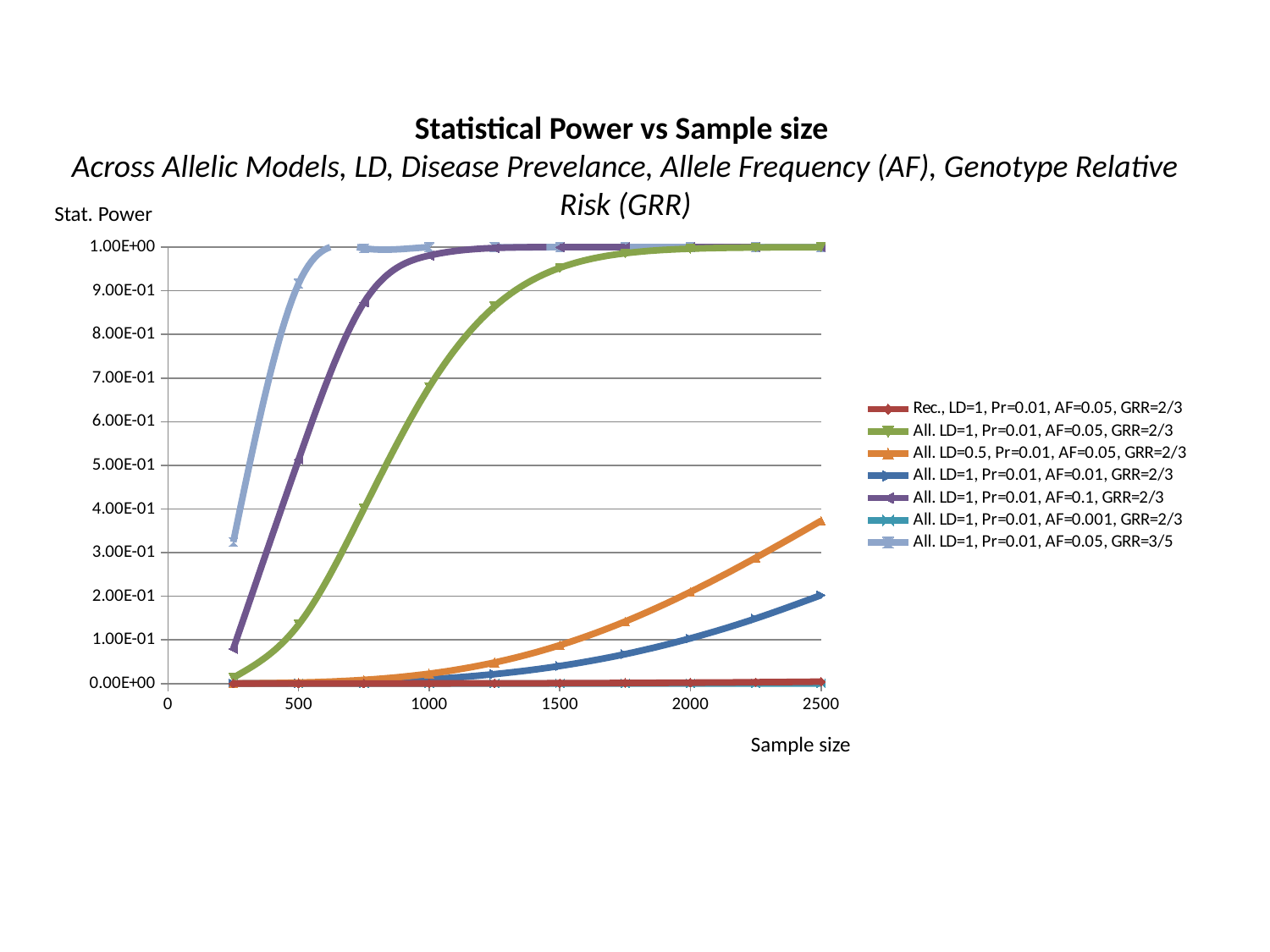
How many series does the legend list? 7 Is the value for 'All. LD=1, Pr=0.01, AF=0.01, GRR=2/3' at sample size 2500 greater or less than 3.00E-01? less Is the value for 'All. LD=1, Pr=0.01, AF=0.05, GRR=3/5' at sample size 500 greater or less than 8.00E-01? greater What is the title of the chart (first line)? Statistical Power vs Sample size At sample size 2500, which series has the higher value: 'All. LD=0.5, Pr=0.01, AF=0.05, GRR=2/3' or 'All. LD=1, Pr=0.01, AF=0.01, GRR=2/3'? All. LD=0.5, Pr=0.01, AF=0.05, GRR=2/3 Is the value for 'All. LD=0.5, Pr=0.01, AF=0.05, GRR=2/3' at sample size 2500 greater or less than 3.00E-01? greater What is the label on the x axis? Sample size Does the value for 'All. LD=0.5, Pr=0.01, AF=0.05, GRR=2/3' rise or fall as sample size increases? rise At sample size 1000, which series has the higher value: 'All. LD=1, Pr=0.01, AF=0.1, GRR=2/3' or 'All. LD=1, Pr=0.01, AF=0.05, GRR=2/3'? All. LD=1, Pr=0.01, AF=0.1, GRR=2/3 What kind of chart is shown on the slide? Line chart